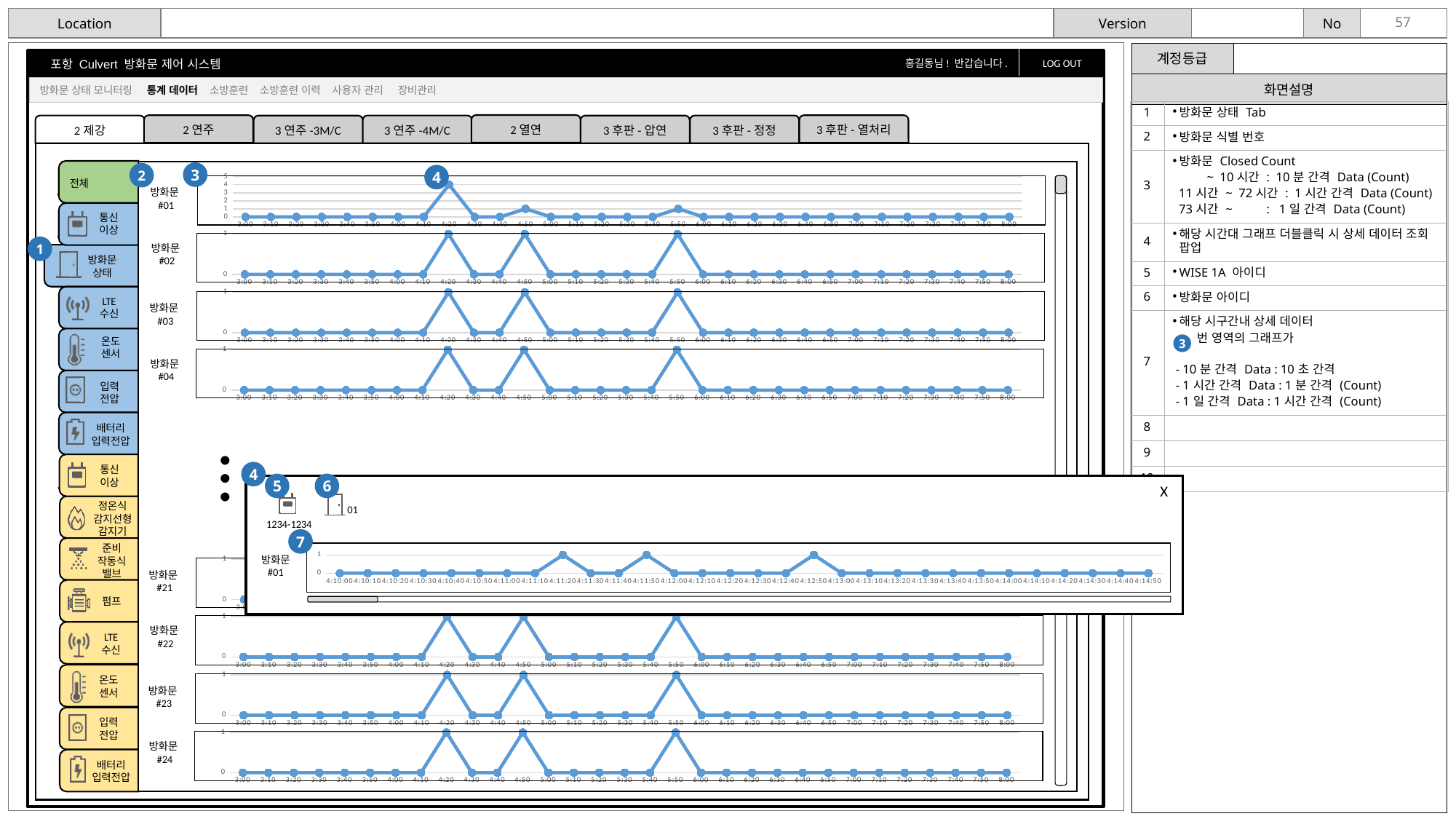
In the popup chart labelled 방화문 #01, at which times does the line rise to 1? 4:11:20, 4:11:50, 4:12:50 In the popup chart labelled 방화문 #01, what is the first time shown on the x axis? 4:10:00 In the 방화문 #03 chart, at which times does the line rise to 1? 4:20, 4:50, 5:50 In the 방화문 #01 chart (top chart), which is larger, the value at 4:20 or the value at 4:50? 4:20 In the 방화문 #01 chart (top chart), at which time does the line reach its highest value? 4:20 In the 방화문 #02 chart, what is the value at 4:20? 1 In the 방화문 #02 chart, what is the value at 3:00? 0 What is the highest tick on the y axis of the 방화문 #01 chart (top chart)? 5 In the 방화문 #01 chart (top chart), is the value at 4:50 greater or less than 3? less What kind of chart is used for the 방화문 #02 panel? line chart In the 방화문 #24 chart, what is the value at 8:00? 0 In the 방화문 #01 chart (top chart), what value does the line reach at 4:20? 4